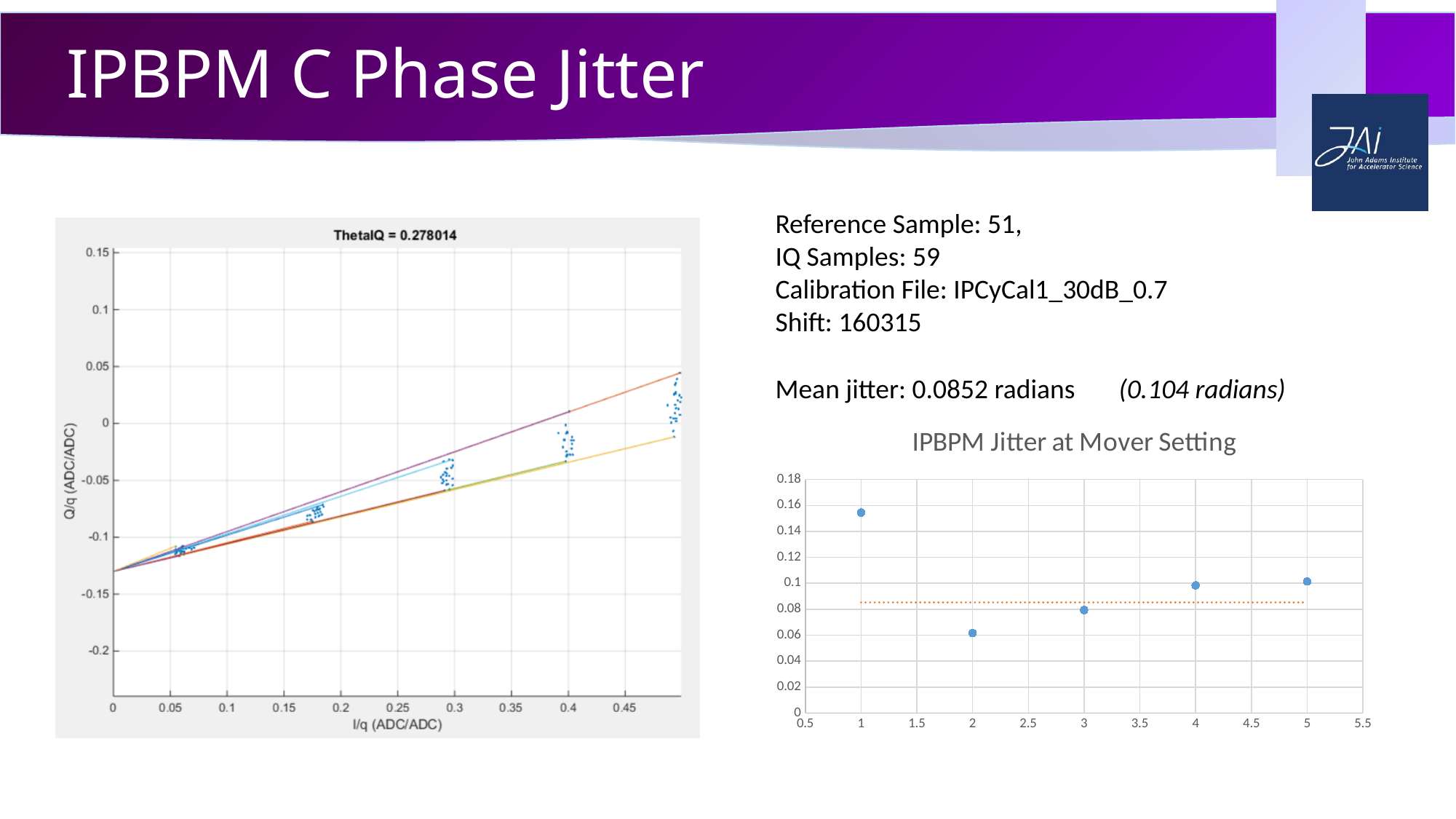
In the 'IPBPM Jitter at Mover Setting' chart, is the value at mover setting 2 greater or less than 0.08? less In the 'IPBPM Jitter at Mover Setting' chart, at which mover setting (x value) is the jitter highest? 1 In the 'IPBPM Jitter at Mover Setting' chart, which has the larger jitter value: mover setting 3 or mover setting 5? mover setting 5 In the 'IPBPM Jitter at Mover Setting' chart, is the value at mover setting 5 greater or less than 0.08? greater In the 'IPBPM Jitter at Mover Setting' chart, is the value at mover setting 3 greater or less than 0.1? less What is the title shown above the chart on the left side of the slide? ThetaIQ = 0.278014 In the 'IPBPM Jitter at Mover Setting' chart, at which mover setting (x value) is the jitter lowest? 2 What is the title of the chart on the right side of the slide? IPBPM Jitter at Mover Setting How many data points are plotted in the 'IPBPM Jitter at Mover Setting' chart? 5 In the 'IPBPM Jitter at Mover Setting' chart, which has the larger jitter value: mover setting 1 or mover setting 2? mover setting 1 What kind of chart is the 'IPBPM Jitter at Mover Setting' chart? scatter chart